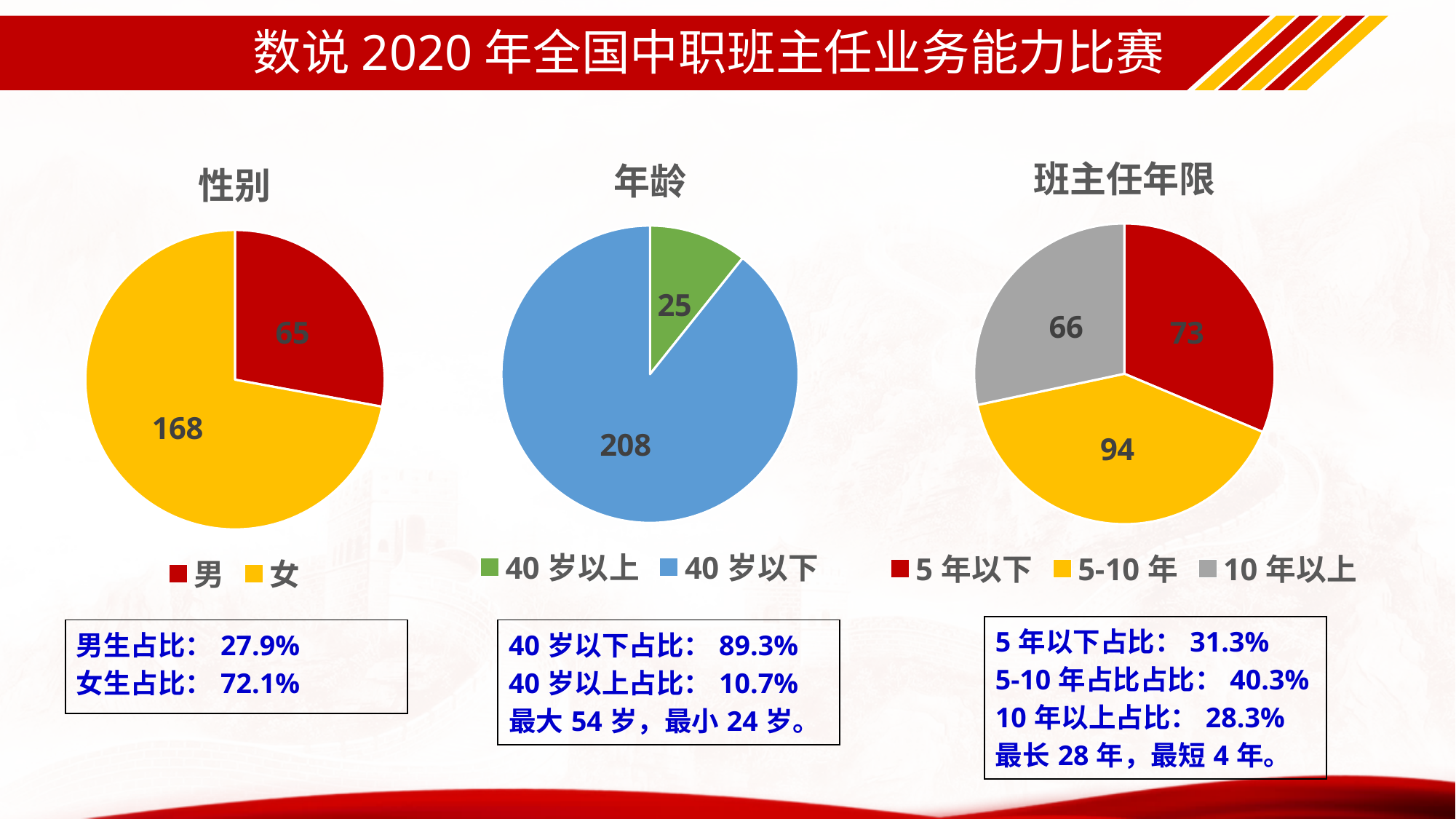
In the 班主任年限 chart, which category has the highest value? 5-10 年 In the 班主任年限 chart, what is the value for 5 年以下? 73 In the 年龄 chart, what share of the pie does 40 岁以下 represent? 89.3% In the 性别 chart, what is the value for 男? 65 In the 年龄 chart, what is the value for 40 岁以上? 25 In the 性别 chart, what is the difference between the values for 女 and 男? 103 In the 年龄 chart, what is the value for 40 岁以下? 208 In the 班主任年限 chart, which category has the lowest value? 10 年以上 In the 性别 chart, what share of the pie does 男 represent? 27.9% In the 性别 chart, what is the value for 女? 168 What type of chart is the 年龄 chart? pie chart In the 班主任年限 chart, how many categories does the legend list? 3